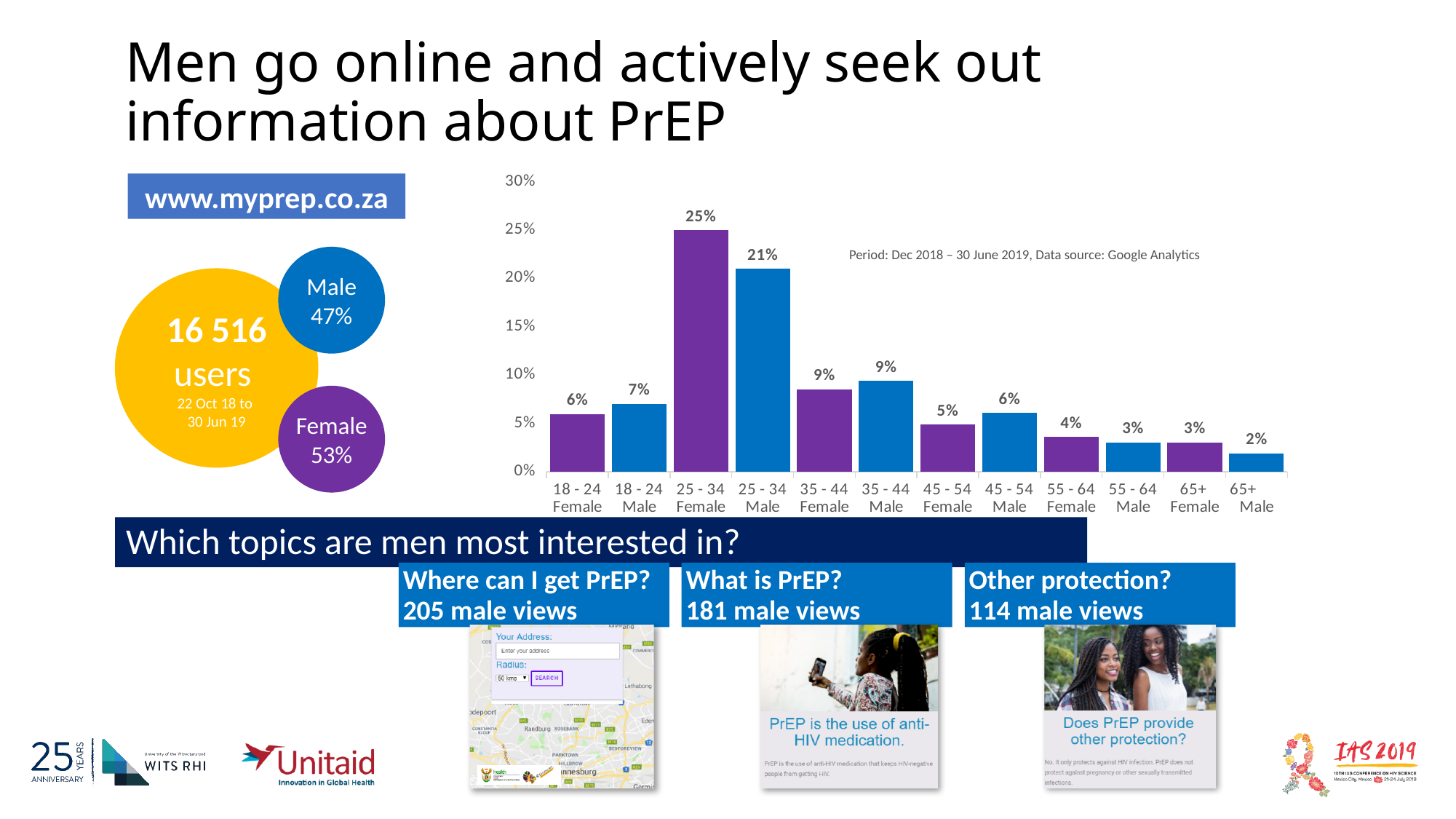
What is the value for 25 - 34 Female? 25% What is the difference between the values for 25 - 34 Female and 25 - 34 Male? 4% What is the value for 25 - 34 Male? 21% Which category has the highest value in the bar chart? 25 - 34 Female What data source is named in the note on the bar chart? Google Analytics What kind of chart is shown on the slide? bar chart What is the value for 55 - 64 Female? 4% Which is larger, the value for 18 - 24 Male or 18 - 24 Female? 18 - 24 Male Which category has the lowest value in the bar chart? 65+ Male Is the value for 25 - 34 Female greater or less than 20%? greater How many categories are plotted in the bar chart? 12 Do the values rise or fall along the x axis from 25 - 34 Female to 65+ Male? fall